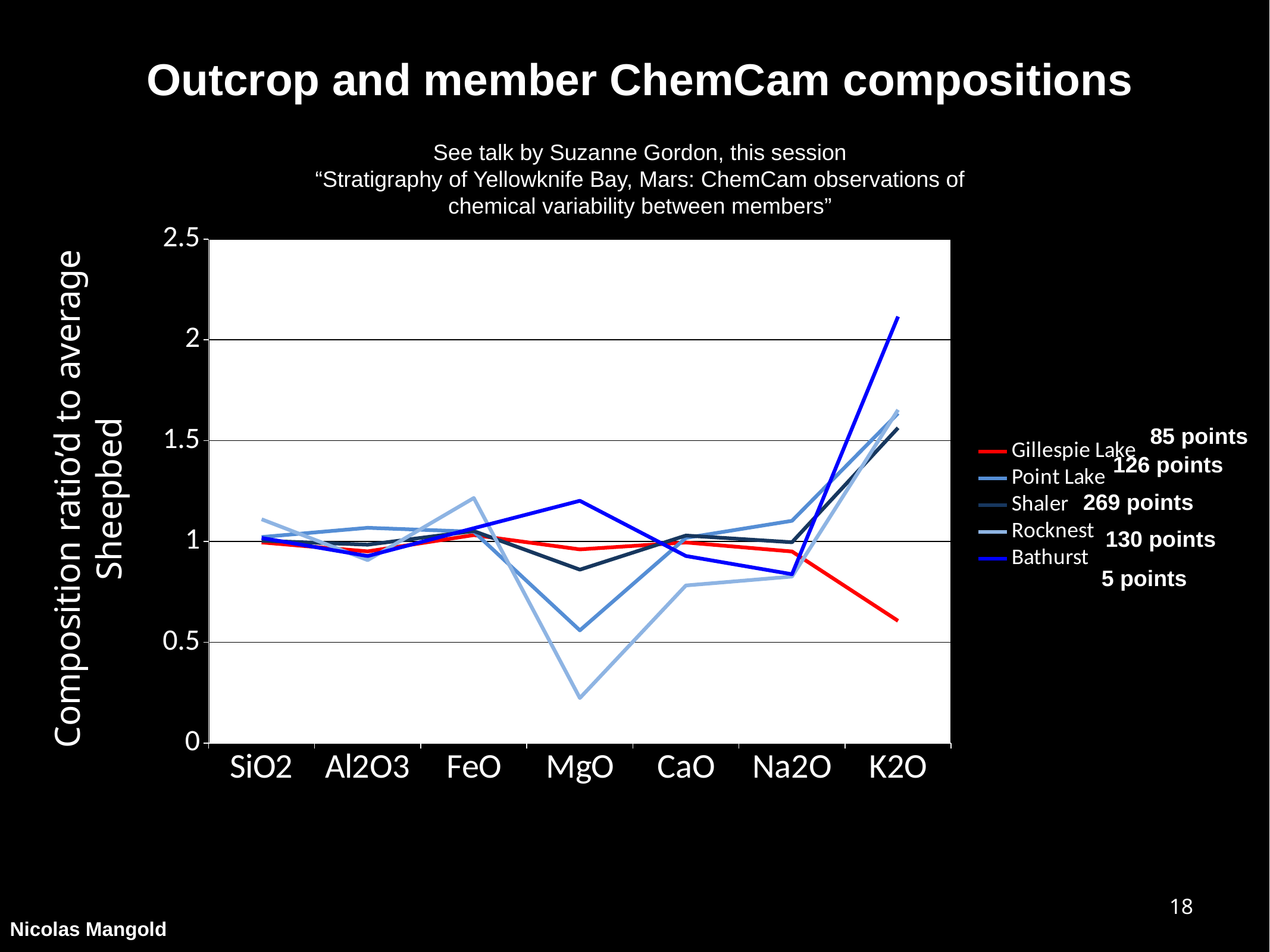
Does the Gillespie Lake line rise or fall from Na2O to K2O? fall What kind of chart is shown on the slide? line chart Which series has the lowest value at K2O? Gillespie Lake At MgO, which is larger: the value for Bathurst or the value for Rocknest? Bathurst Which series has the highest value at K2O? Bathurst How many oxide categories are shown along the x axis? 7 Which series has the lowest value at MgO? Rocknest What colour is the Gillespie Lake line in the legend? red Is the value for Bathurst at K2O greater or less than 2? greater Is the value for Rocknest at MgO greater or less than 0.5? less How many series does the legend list? 5 Is the value for Bathurst at MgO greater or less than 1? greater